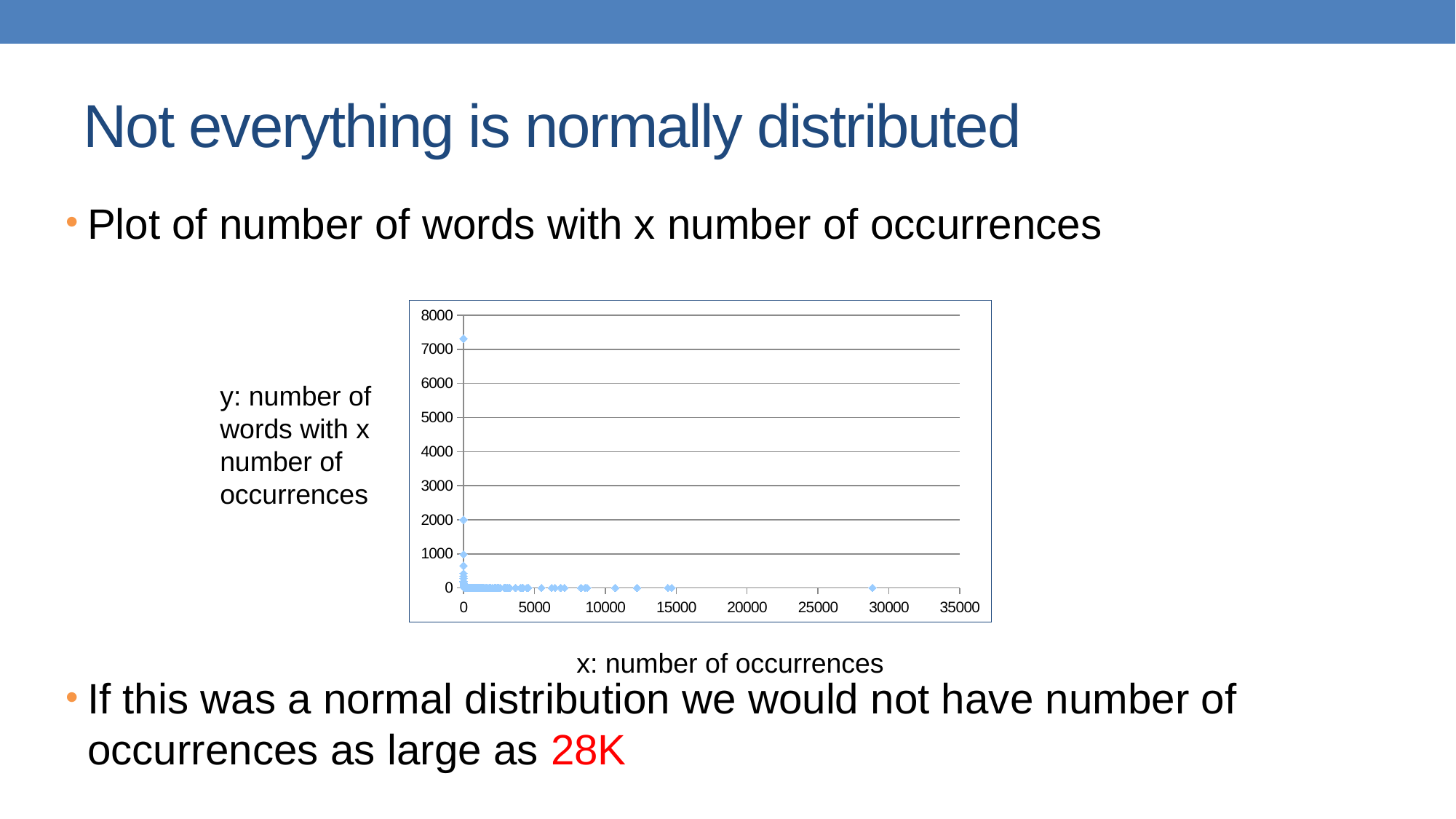
Is the highest y value plotted on the chart greater or less than 7000? greater Is the largest x value (number of occurrences) plotted on the chart greater or less than 30000? less What kind of chart is shown on the slide? scatter plot What is the maximum value shown on the chart's y axis? 8000 Is the largest x value (number of occurrences) plotted on the chart greater or less than 25000? greater Where along the x axis is the point with the highest y value located: near 0 or near 35000? near 0 What is the maximum value shown on the chart's x axis? 35000 As the number of occurrences (x) increases, do the plotted y values generally rise or fall? fall